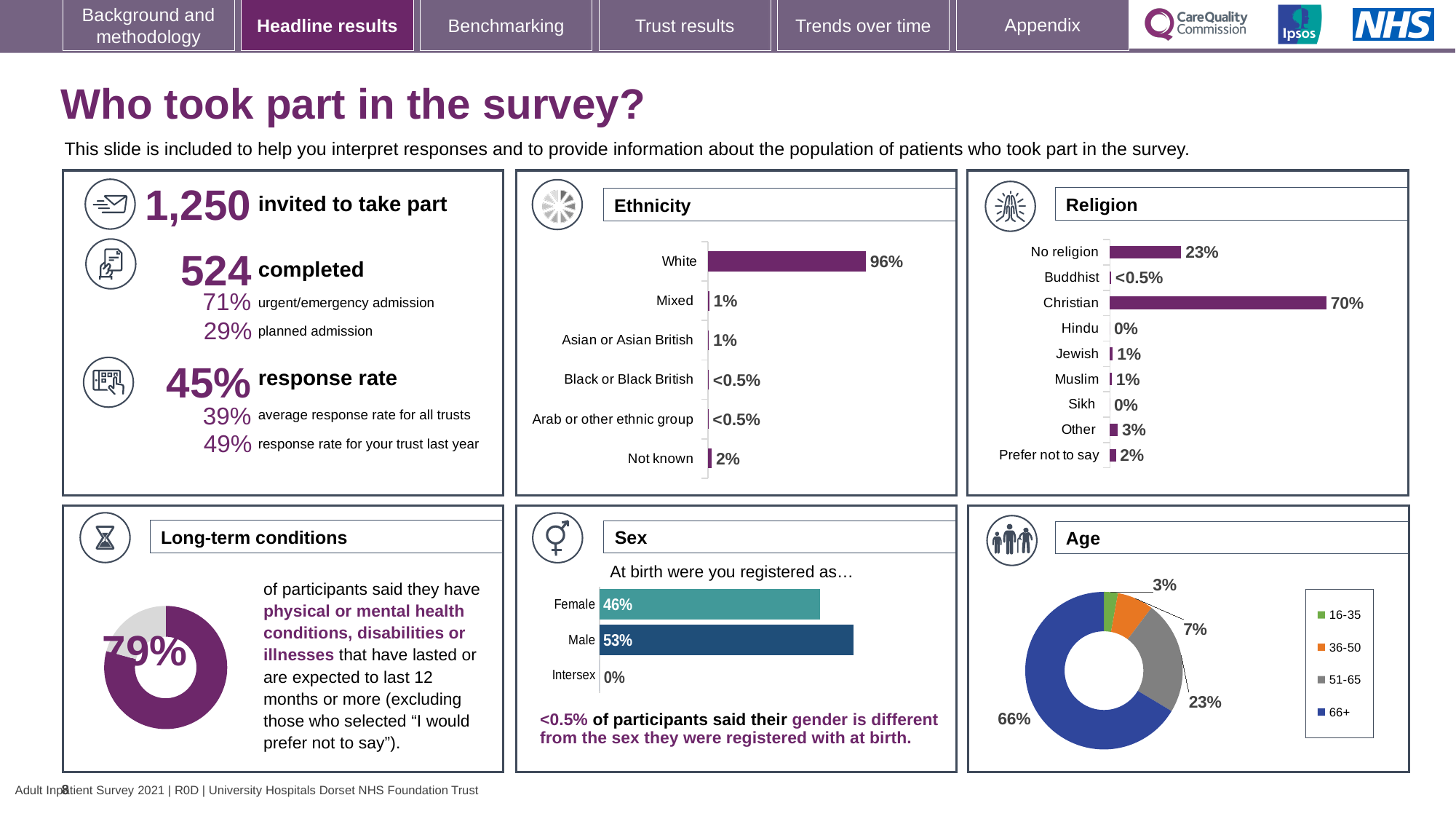
In the Religion chart, what percentage of participants said they had no religion? 23% In the Religion chart, what is the difference between the Christian and No religion percentages? 47 percentage points In the Religion chart, what percentage of participants selected Other? 3% In the Sex chart, which is larger, the Female or the Male percentage? Male In the Ethnicity chart, what percentage of participants were recorded as Not known? 2% In the Age chart, what share of participants were aged 66+? 66% In the Sex chart, what percentage of participants were registered as Male at birth? 53% In the Age chart, how many age groups does the legend list? 4 What kind of chart is used in the Age panel? Doughnut chart In the Ethnicity chart, how many ethnicity categories are shown? 6 In the Religion chart, which religion category has the highest percentage? Christian In the Ethnicity chart, what percentage of participants were White? 96%